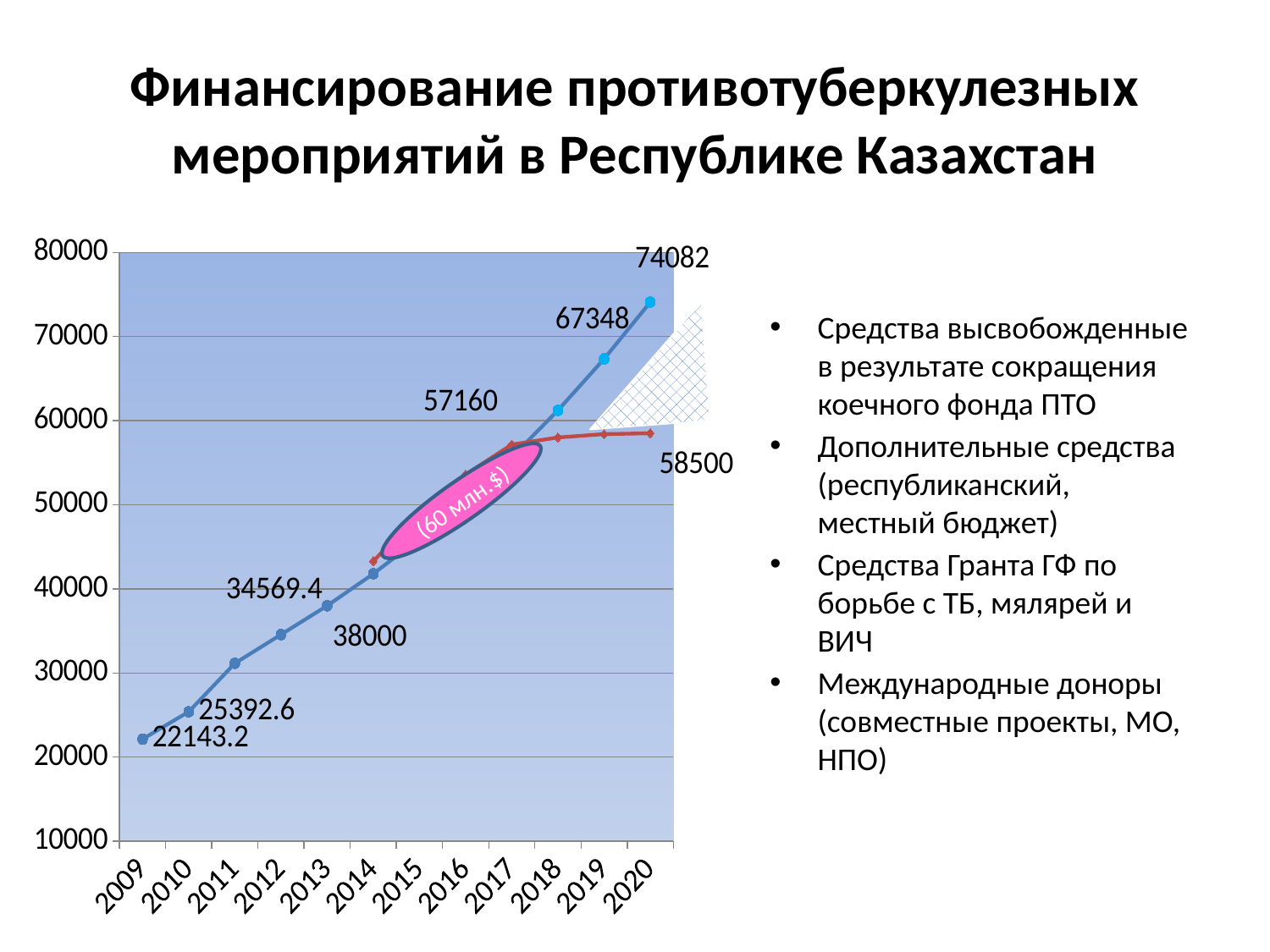
How many years are shown on the x axis of the chart? 12 Does the blue line rise or fall from 2009 to 2020? rise What kind of chart is shown on the slide? line chart Which year has the lowest value on the blue line? 2009 By how much did the blue line value increase from 2009 to 2010? 3249.4 Which year has the highest value on the blue line? 2020 What is the value of the blue line for 2020? 74082 What is the value of the red line for 2020? 58500 Is the value of the blue line for 2014 greater or less than 40000? greater What is the value of the blue line for 2010? 25392.6 What is the difference between the blue line value and the red line value in 2020? 15582 What is the value of the blue line for 2009? 22143.2